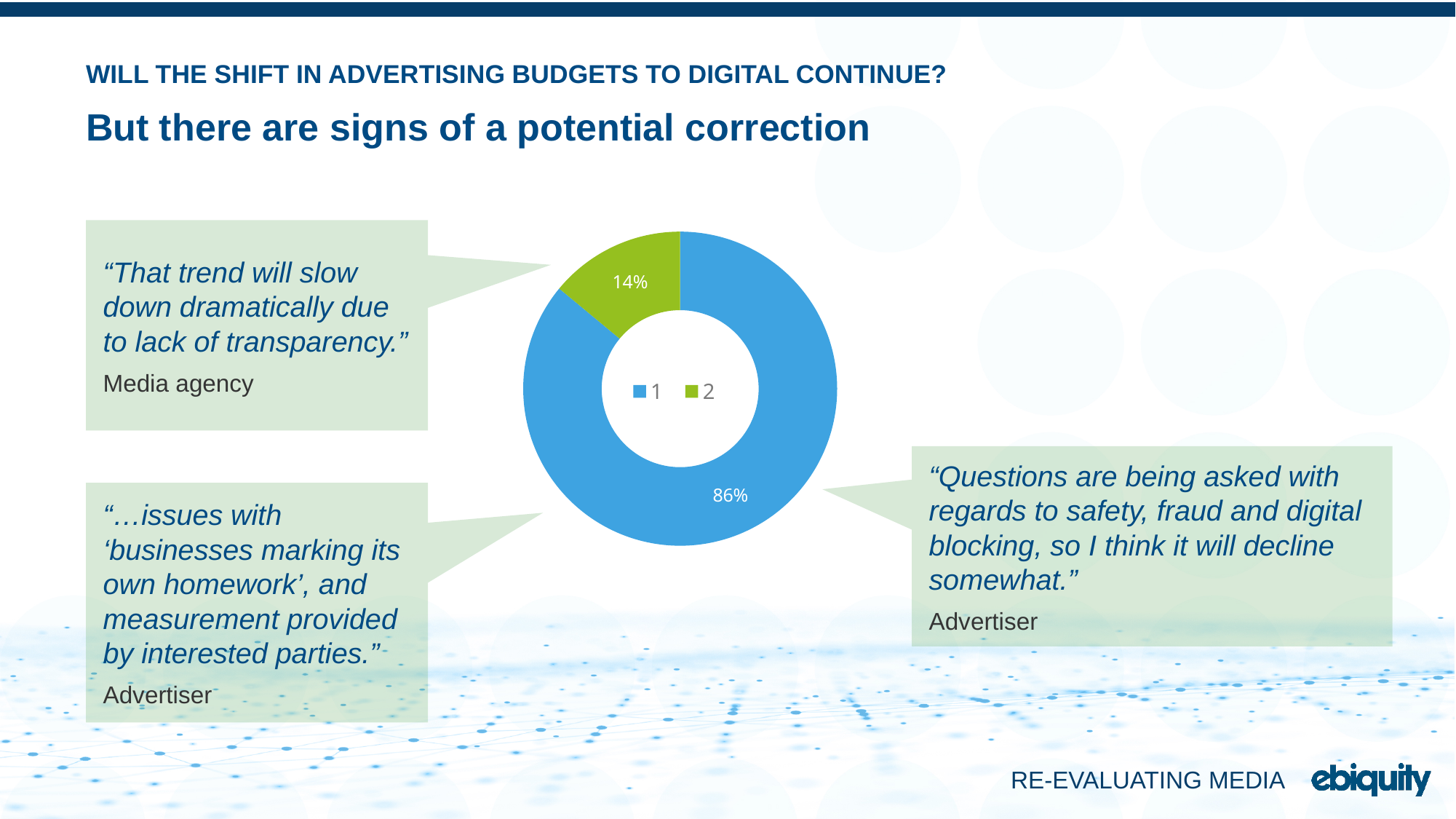
Which is larger, the slice for category 1 or the slice for category 2? 1 What is the total of the two slices shown in the doughnut chart? 100% What colour is the slice for category 2? Green How many entries does the legend list? 2 What colour is the slice for category 1? Blue What kind of chart is shown on the slide? Doughnut (pie) chart How many slices does the doughnut chart have? 2 What is the difference in percentage points between category 1 and category 2? 72 What share of the doughnut chart does category 2 represent? 14% What share of the doughnut chart does category 1 represent? 86% Which category has the largest slice in the doughnut chart? 1 Which category has the smallest slice in the doughnut chart? 2